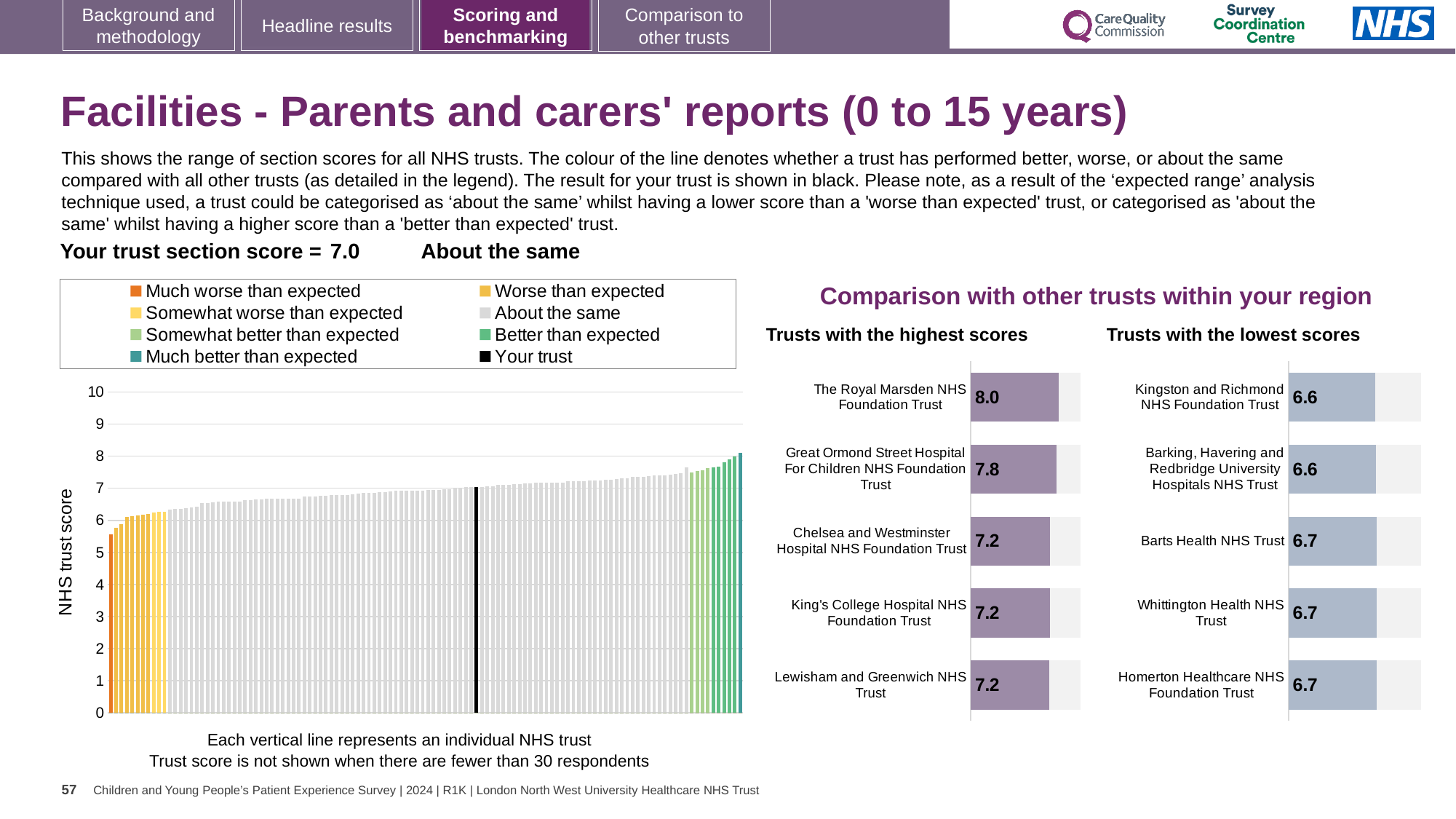
In the 'Trusts with the highest scores' chart, what is the difference between the scores of The Royal Marsden NHS Foundation Trust and Great Ormond Street Hospital For Children NHS Foundation Trust? 0.2 In the 'Trusts with the lowest scores' chart, what is the score for Barts Health NHS Trust? 6.7 How many trusts are shown in the 'Trusts with the lowest scores' chart? 5 How many entries does the legend of the large chart on the left list? 8 In the 'Trusts with the highest scores' chart, which trust has the highest score? The Royal Marsden NHS Foundation Trust Which is larger: the score for The Royal Marsden NHS Foundation Trust in the 'highest scores' chart or the score for Homerton Healthcare NHS Foundation Trust in the 'lowest scores' chart? The Royal Marsden NHS Foundation Trust In the large chart on the left, do the trust scores rise or fall from left to right? rise In the 'Trusts with the highest scores' chart, what is the score for Great Ormond Street Hospital For Children NHS Foundation Trust? 7.8 In the large chart on the left, what is the section score for your trust (the black line)? 7.0 In the 'Trusts with the highest scores' chart, what is the score for The Royal Marsden NHS Foundation Trust? 8.0 In the 'Trusts with the lowest scores' chart, what is the score for Kingston and Richmond NHS Foundation Trust? 6.6 In the large chart on the left, is the value of the leftmost (orange) bar greater or less than 6? less